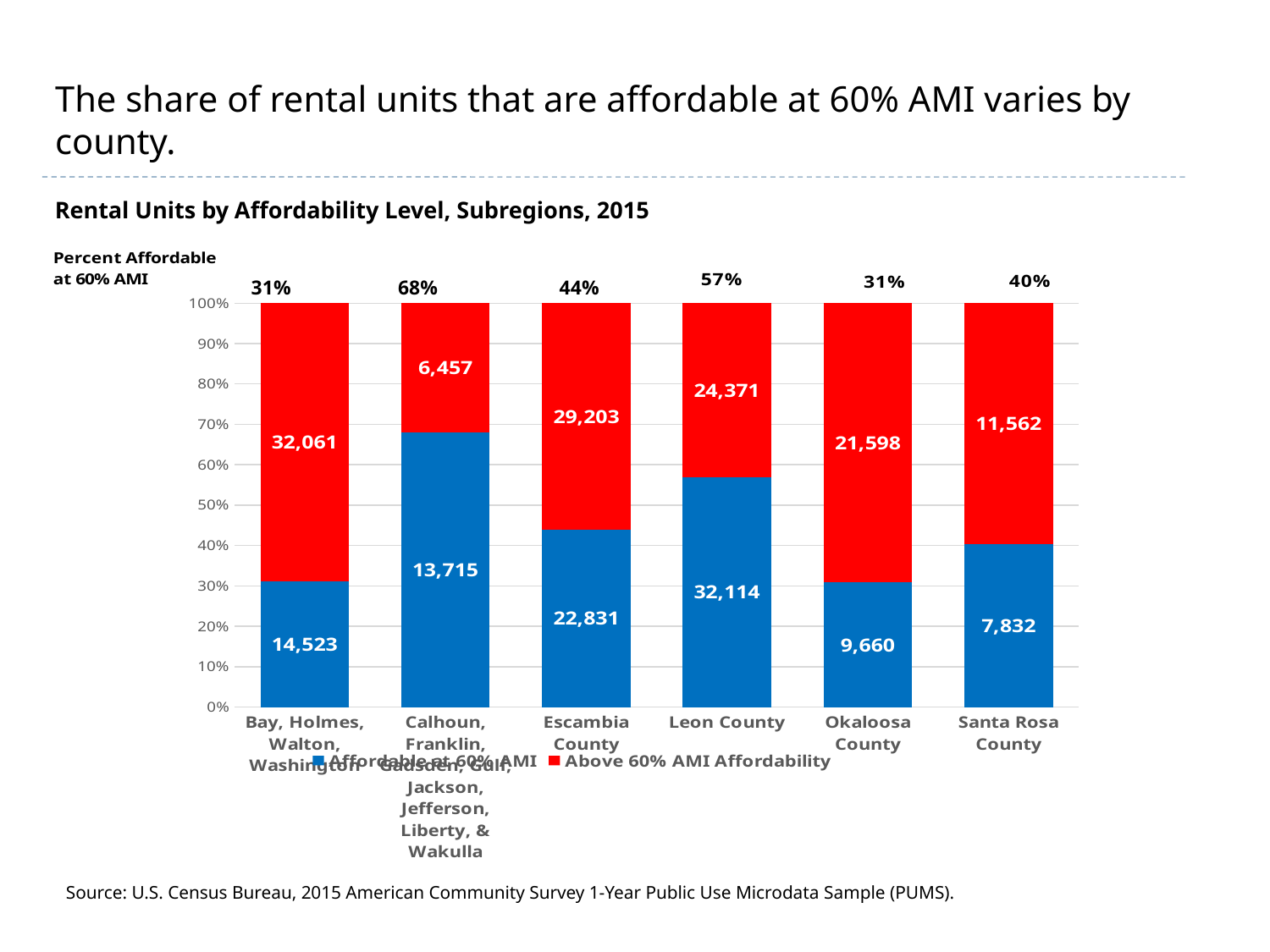
Which subregion has the highest percent of rental units affordable at 60% AMI? Calhoun, Franklin, Gadsden, Gulf, Jackson, Jefferson, Liberty, & Wakulla Which has more rental units affordable at 60% AMI: Escambia County or Leon County? Leon County What is the total number of rental units shown for Santa Rosa County? 19,394 What type of chart is shown on the slide? Stacked bar chart What is the difference between the number of units above 60% AMI affordability and the number affordable at 60% AMI in the Bay, Holmes, Walton, Washington subregion? 17,538 How many series does the legend list? 2 How many rental units in Leon County are affordable at 60% AMI? 32,114 Which subregion has the fewest rental units affordable at 60% AMI? Santa Rosa County How many subregions are shown on the x axis? 6 What is the title of the chart? Rental Units by Affordability Level, Subregions, 2015 How many rental units in Okaloosa County are above 60% AMI affordability? 21,598 What is the percent of rental units affordable at 60% AMI for Escambia County? 44%